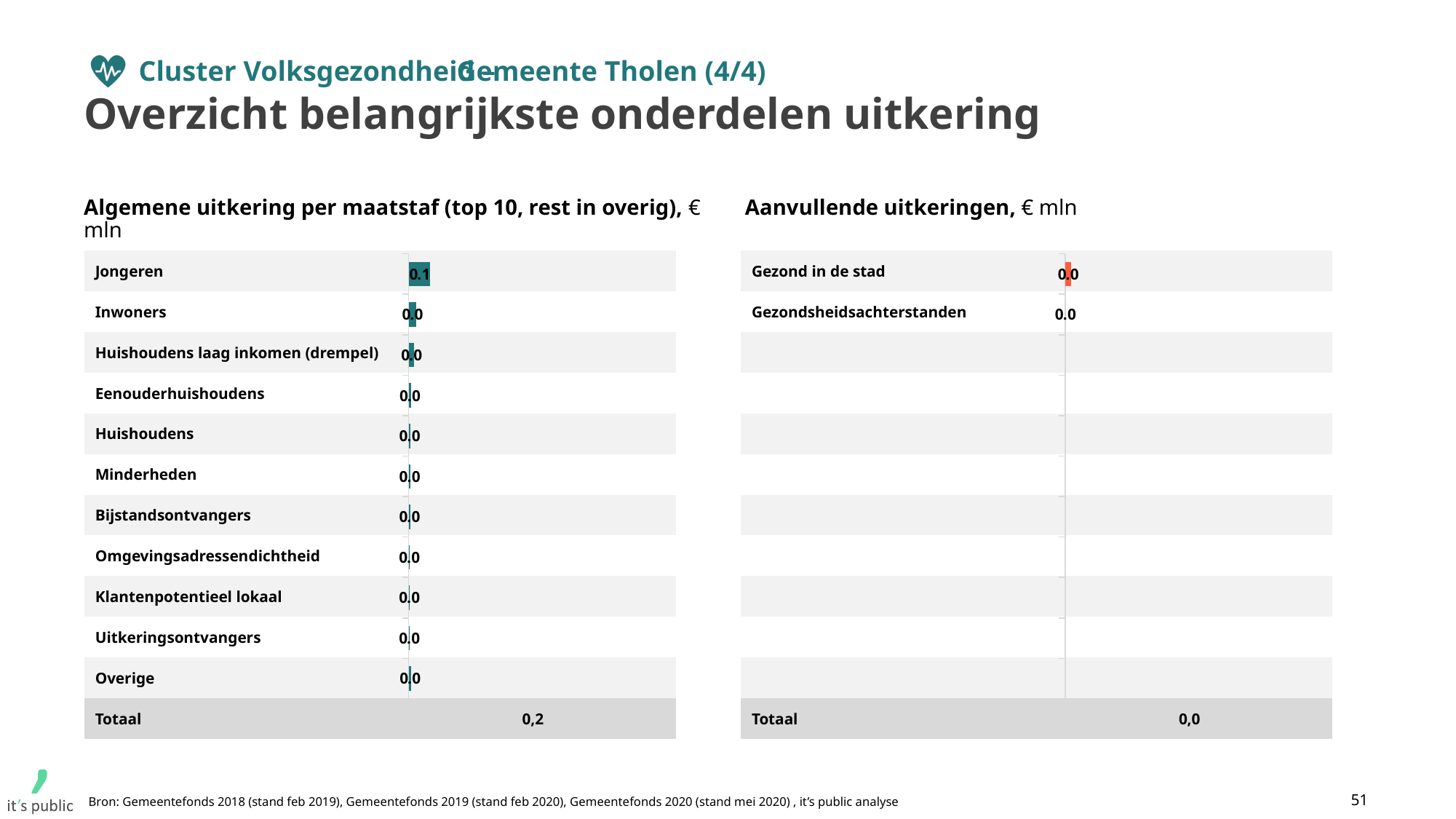
In the left chart (Algemene uitkering per maatstaf), which category has the highest value? Jongeren In the left chart (Algemene uitkering per maatstaf), what is the value for Jongeren? 0.1 In the right chart (Aanvullende uitkeringen), how many categories are shown (excluding the Totaal row)? 2 In the right chart (Aanvullende uitkeringen), what is the value for Gezond in de stad? 0.0 In the right chart (Aanvullende uitkeringen), what is the Totaal value? 0,0 In the left chart (Algemene uitkering per maatstaf), what is the difference between the value for Jongeren and the value for Overige? 0.1 What kind of chart is the left chart (Algemene uitkering per maatstaf)? Bar chart In the left chart (Algemene uitkering per maatstaf), what is the value for Inwoners? 0.0 In the left chart (Algemene uitkering per maatstaf), what is the Totaal value? 0,2 In the left chart (Algemene uitkering per maatstaf), which is larger: the value for Jongeren or the value for Huishoudens? Jongeren What unit is stated in the title of the right chart (Aanvullende uitkeringen)? € mln In the left chart (Algemene uitkering per maatstaf), how many categories are shown (including Overige, excluding the Totaal row)? 11